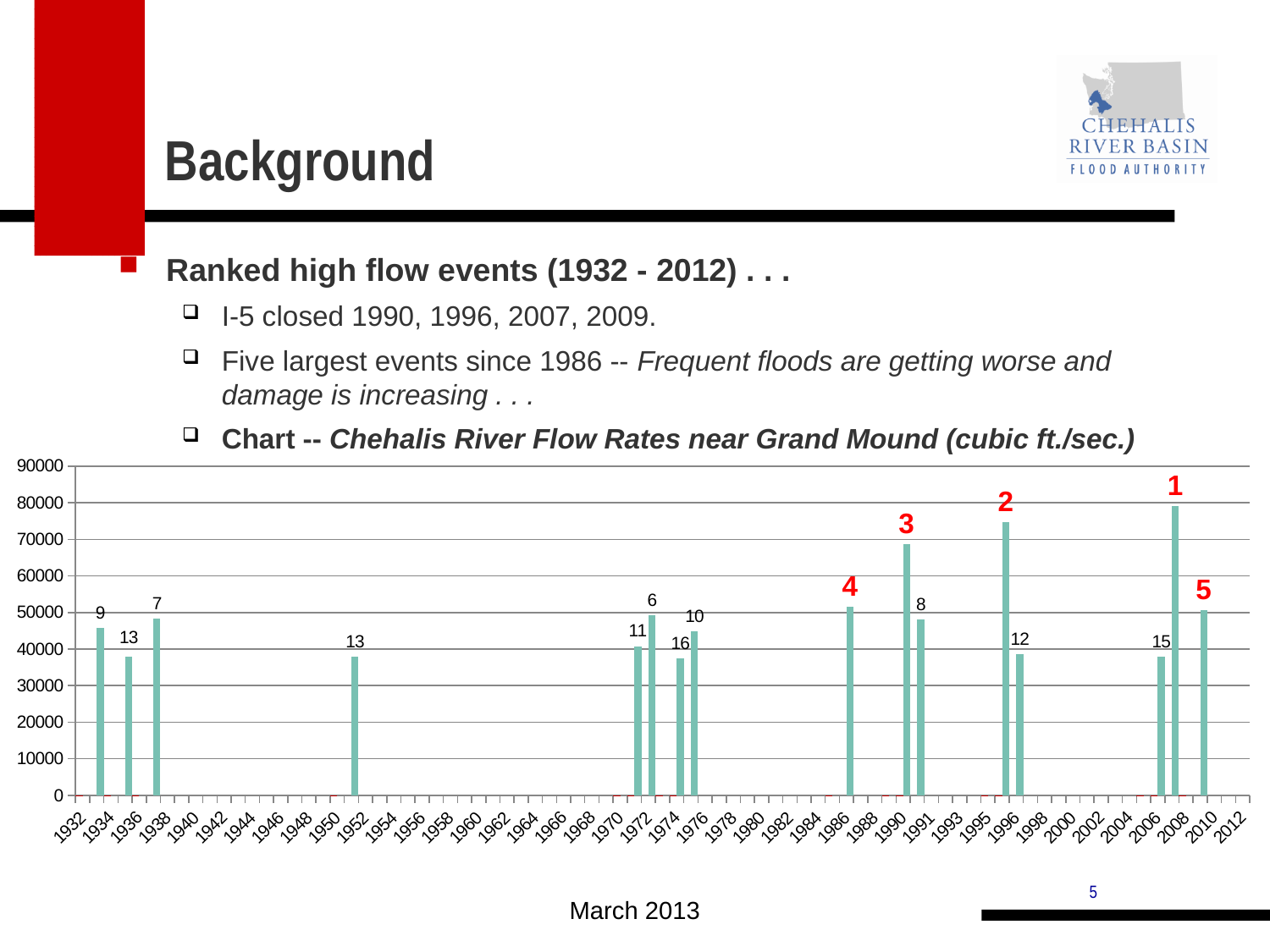
Is the value of the bar labeled 5 greater or less than 60000? less Is the value of the bar labeled 1 greater or less than 70000? greater What is the highest value shown on the chart's vertical axis? 90000 What kind of chart is shown on the slide? bar chart How many bars are plotted in the chart? 16 According to the slide, what does the chart show? Chehalis River Flow Rates near Grand Mound (cubic ft./sec.) Is the value of the bar labeled 2 greater or less than 70000? greater Which rank label is on the tallest bar in the chart? 1 Which is taller, the bar labeled 1 or the bar labeled 2? the bar labeled 1